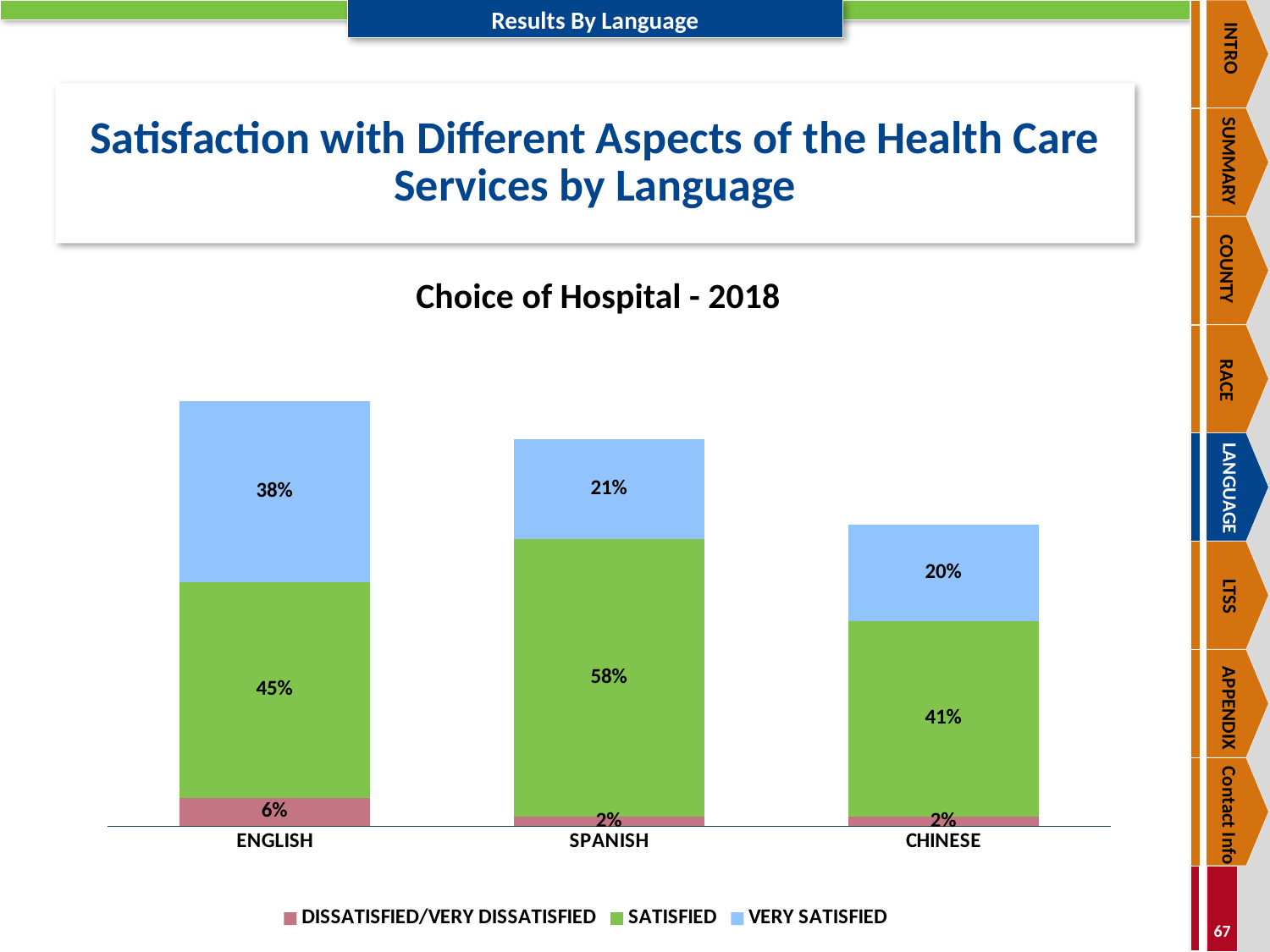
What is the Dissatisfied/Very Dissatisfied value for Chinese? 2% What is the Very Satisfied value for English? 38% What kind of chart is shown? Stacked bar chart What is the difference between the Satisfied values for Spanish and Chinese? 17% What is the total of the stacked bar for English? 89% Which language has the lowest Very Satisfied value? Chinese How many series does the legend list? 3 What is the title of the chart? Choice of Hospital - 2018 What is the Satisfied value for Spanish? 58% Which is larger, the Very Satisfied value for English or for Spanish? English Which language has the highest Satisfied value? Spanish How many languages are shown on the x axis? 3